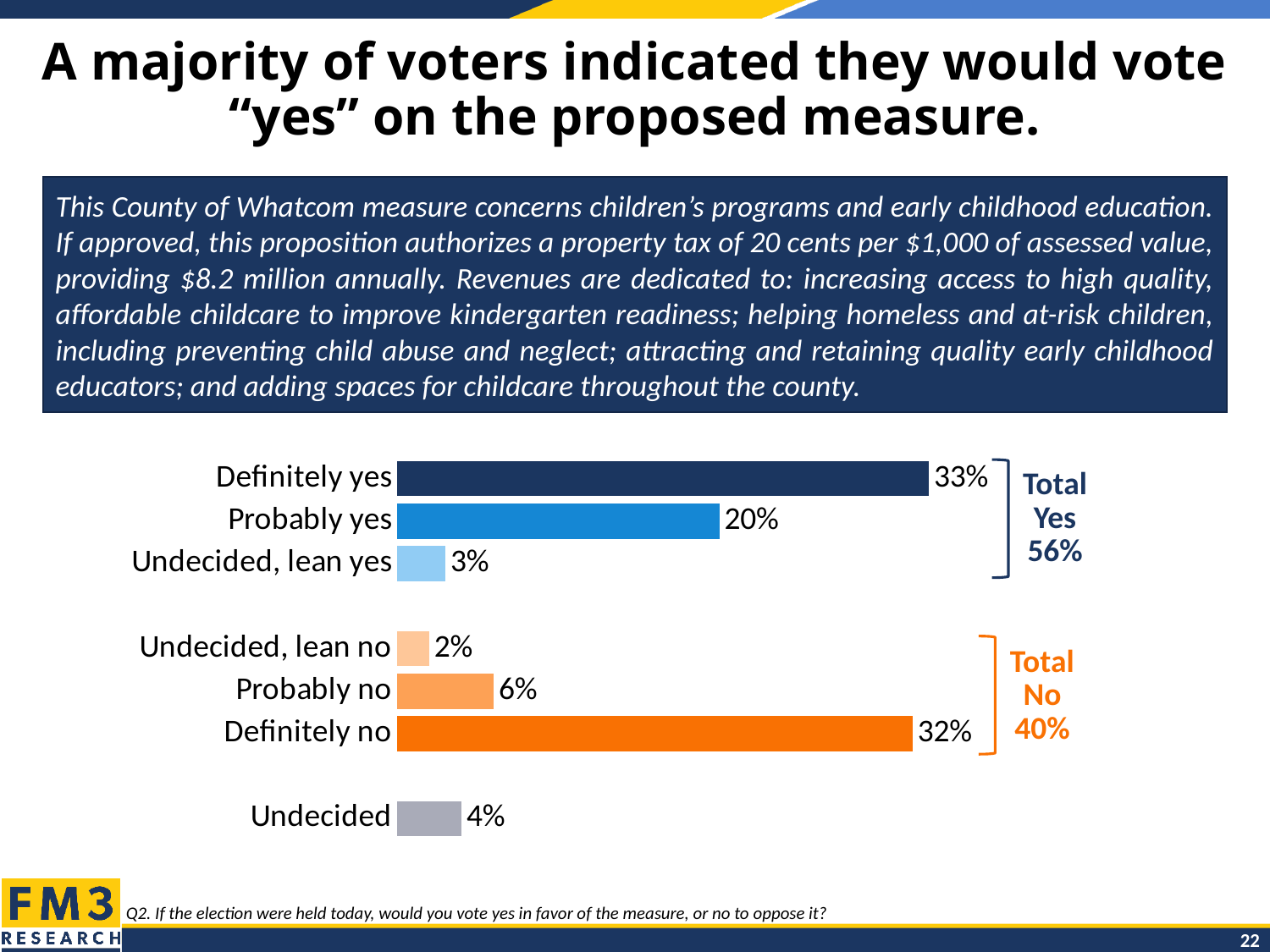
What is the difference between the "Probably yes" and "Probably no" percentages? 14% What percentage of voters said "Probably no"? 6% How many response categories are shown in the chart? 7 What is the Total No percentage shown on the chart? 40% Which response category has the highest percentage? Definitely yes What is the Total Yes percentage shown on the chart? 56% What percentage of voters were "Undecided"? 4% What percentage of voters said "Definitely yes"? 33% What percentage of voters were "Undecided, lean yes"? 3% What kind of chart is shown on the slide? Bar chart Which response category has the lowest percentage? Undecided, lean no Which is larger, the "Definitely yes" percentage or the "Definitely no" percentage? Definitely yes